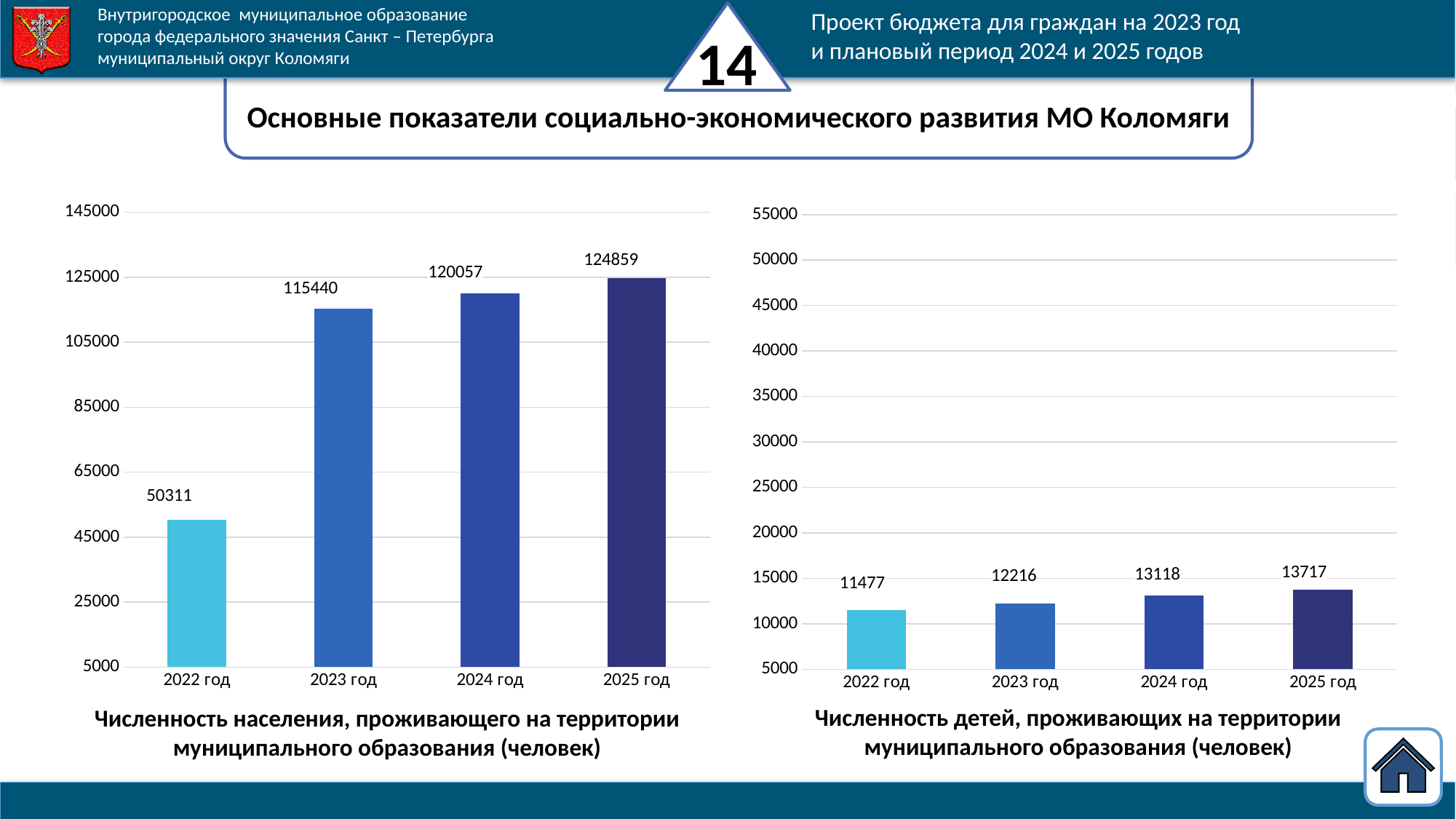
How many bars are shown in the left chart (population)? 4 In the left chart (population), what is the value for 2023 год? 115440 What is the title of the left chart? Численность населения, проживающего на территории муниципального образования (человек) In the right chart (children), what is the value for 2025 год? 13717 In the right chart (children), do the values rise or fall from 2022 год to 2025 год? rise In the left chart (population), which year has the lowest value? 2022 год What type of chart is the right chart (children)? bar chart In the right chart (children), which year has the highest value? 2025 год In the left chart (population), what is the difference between the values for 2025 год and 2024 год? 4802 In the right chart (children), what is the difference between the values for 2023 год and 2022 год? 739 In the left chart (population), which is larger: the value for 2022 год or the value for 2023 год? 2023 год In the right chart (children), is the value for 2024 год greater or less than 15000? less